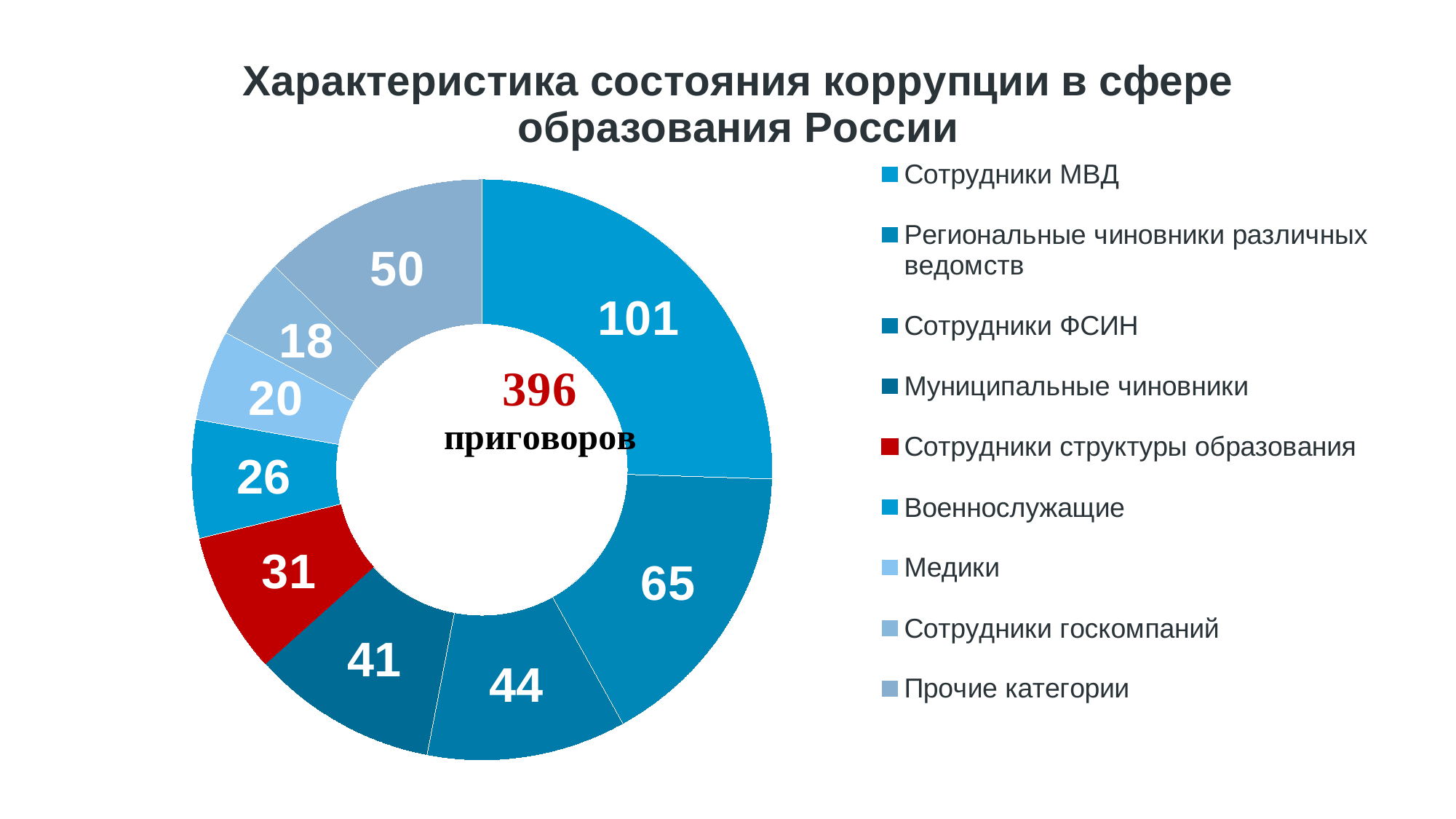
What is the value for Сотрудники МВД? 101 What total number of sentences is shown in the centre of the chart? 396 приговоров What is the difference between the values for Сотрудники МВД and Региональные чиновники различных ведомств? 36 What type of chart is shown on the slide? doughnut (pie) chart How many categories does the legend list? 9 Which category is shown in red on the chart? Сотрудники структуры образования What is the value for Сотрудники структуры образования? 31 What is the value for Прочие категории? 50 Which is larger, the value for Сотрудники ФСИН or the value for Муниципальные чиновники? Сотрудники ФСИН What is the value for Медики? 20 Which category has the highest value? Сотрудники МВД Which category has the lowest value? Сотрудники госкомпаний